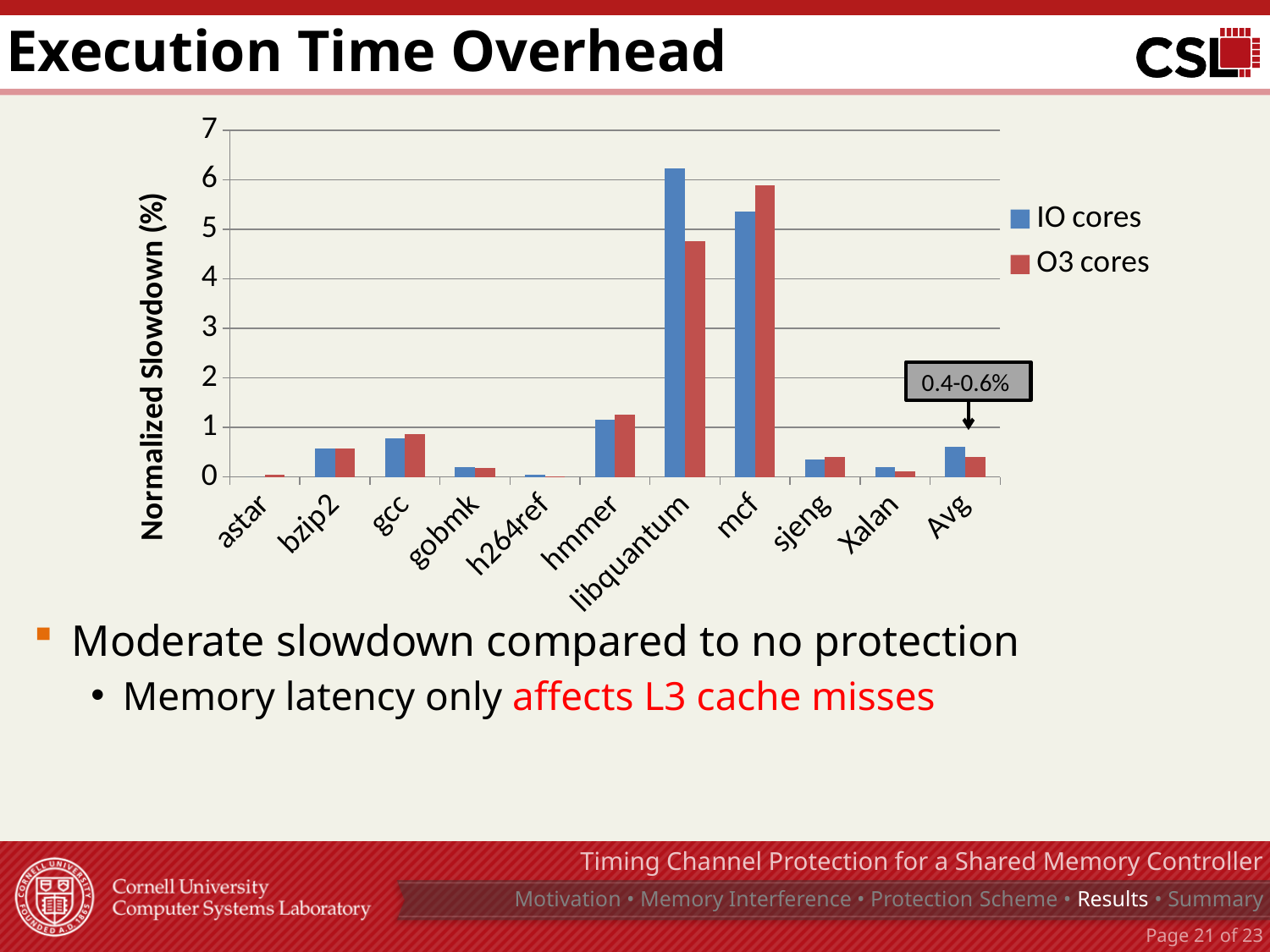
What is the label of the y axis? Normalized Slowdown (%) What range does the annotation above the Avg bars give? 0.4-0.6% Is the value for IO cores on gcc greater or less than 1? less Is the value for O3 cores on libquantum greater or less than 5? less How many benchmark categories are shown on the x axis? 11 For libquantum, which series has the larger value, IO cores or O3 cores? IO cores What kind of chart is shown on the slide? bar chart How many series does the legend list? 2 Which category has the highest value for IO cores? libquantum Which category has the highest value for O3 cores? mcf Is the value for IO cores on libquantum greater or less than 5? greater For mcf, which series has the larger value, IO cores or O3 cores? O3 cores